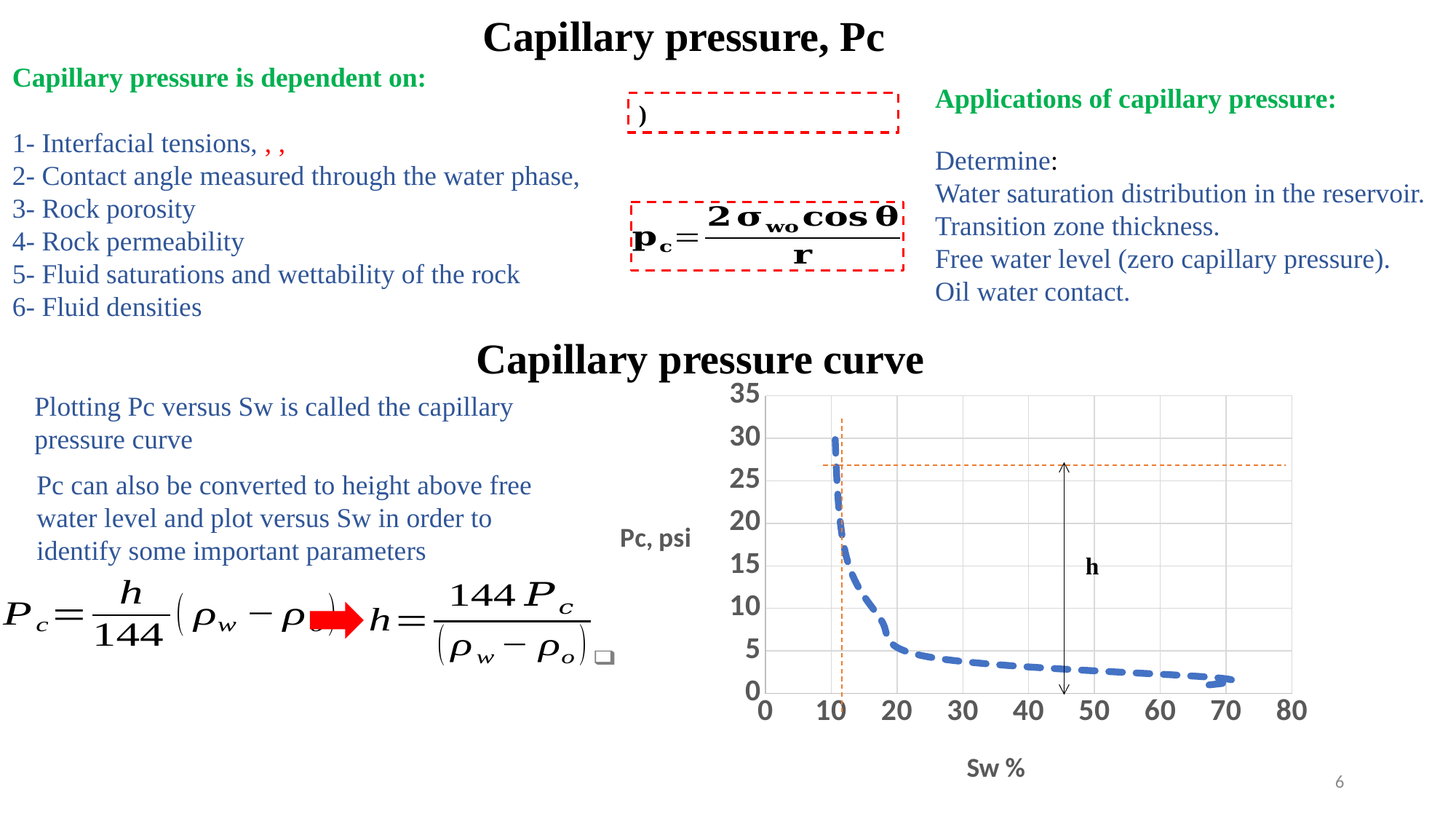
As Sw % increases along the x axis, does the plotted Pc curve rise or fall? fall Is the highest plotted Pc value on the curve greater or less than 25? greater Which has the larger Pc value on the curve: Sw = 20% or Sw = 60%? Sw = 20% What is the label of the horizontal axis of the capillary pressure curve chart? Sw % What is the maximum value shown on the horizontal axis of the capillary pressure curve chart? 80 What kind of chart is shown under the heading "Capillary pressure curve"? line chart Is the value of Pc at Sw = 40% greater or less than 5? less Is the value of Pc at Sw = 20% greater or less than 10? less What is the label of the vertical axis of the capillary pressure curve chart? Pc, psi